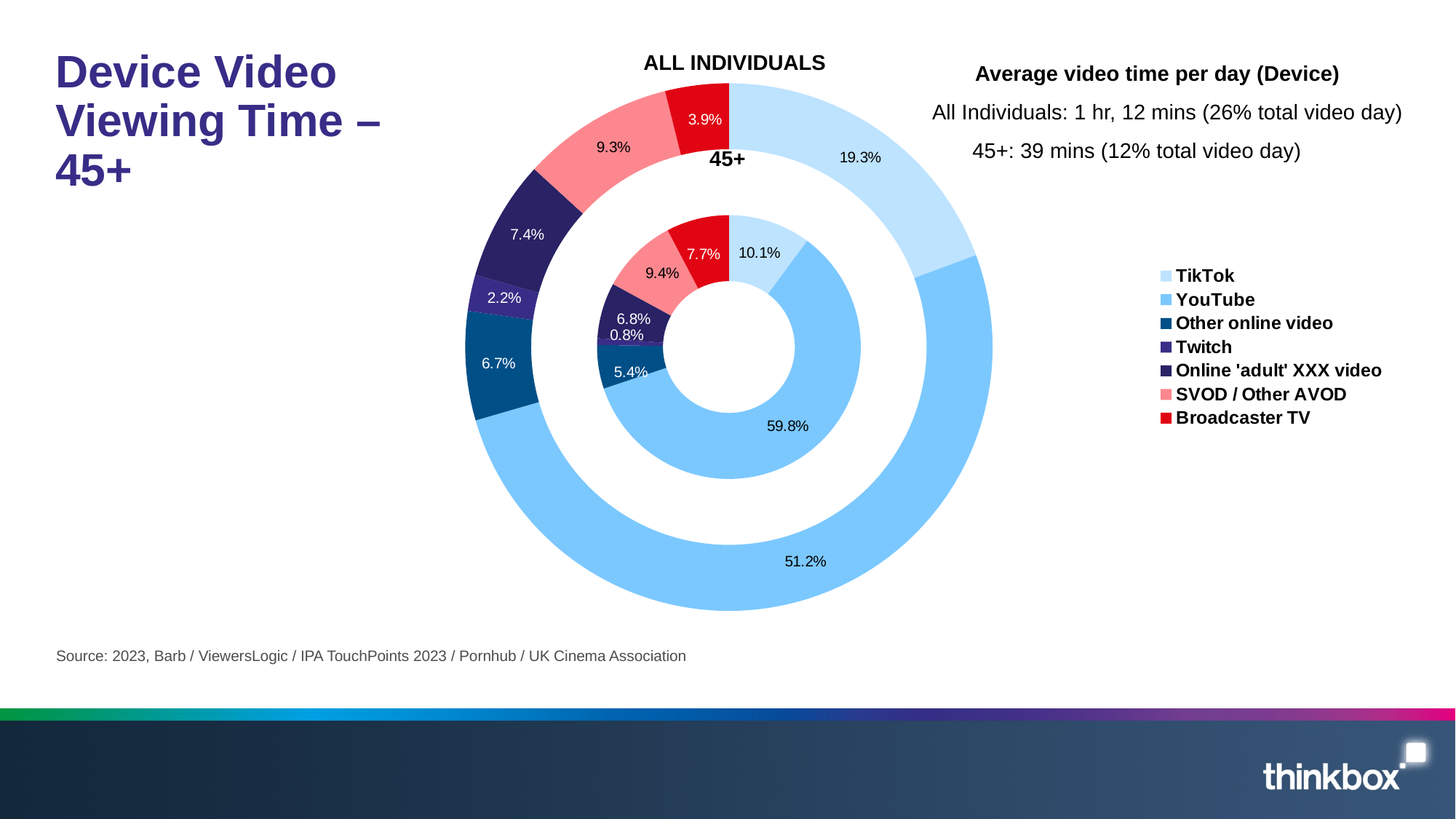
What kind of chart is shown on the slide? Doughnut chart In the inner ring (45+), what share does TikTok have? 10.1% In the outer ring (All Individuals), what share does Broadcaster TV have? 3.9% Which is larger: the Broadcaster TV share for All Individuals or for 45+? 45+ Which ring of the doughnut chart represents the 45+ group, the inner or the outer? Inner In the inner ring (45+), what share does Twitch have? 0.8% In the inner ring (45+), what share does YouTube have? 59.8% What is the difference between the TikTok share for All Individuals (19.3%) and for 45+ (10.1%)? 9.2 percentage points Which category has the largest share in the outer ring (All Individuals)? YouTube In the outer ring (All Individuals), what share does YouTube have? 51.2% Which category has the smallest share in the inner ring (45+)? Twitch How many categories does the legend list? 7